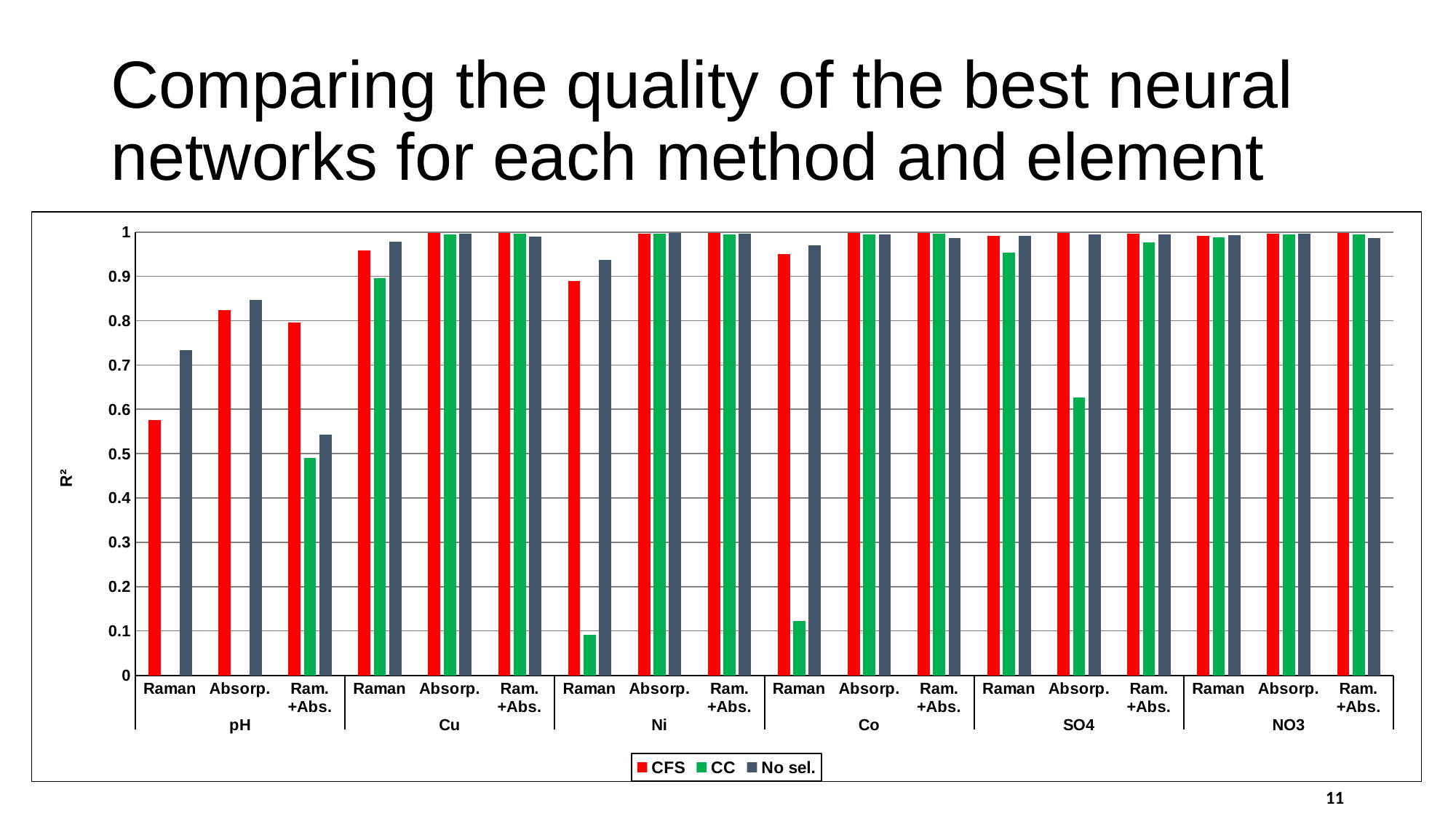
Is the CC value for Raman under Ni greater or less than 0.2? less How many series does the legend list? 3 For Raman under pH, which is larger: CFS or No sel.? No sel. Is the No sel. value for Absorp. under pH greater or less than 0.8? greater Is the CFS value for Raman under pH greater or less than 0.5? greater How many element groups are shown along the x axis? 6 For Absorp. under SO4, which is larger: CFS or CC? CFS What is the label on the y axis? R² What kind of chart is shown on the slide? bar chart